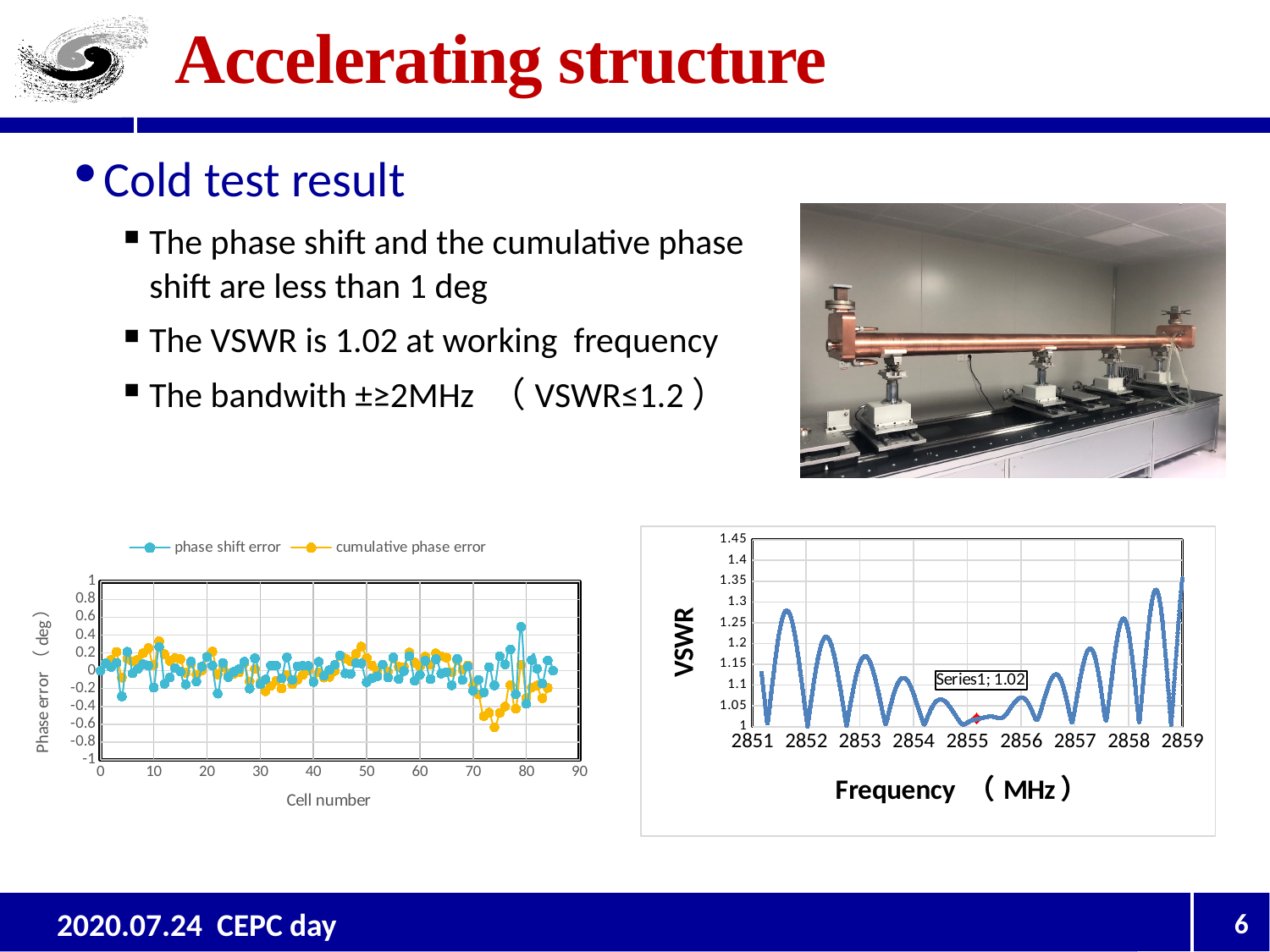
How many series does the legend of the left chart (phase error vs cell number) list? 2 What is the y-axis label of the right chart (VSWR vs frequency)? VSWR What kind of chart is the left chart plotting phase error against cell number? line chart In the right chart (VSWR vs frequency), is the VSWR at 2859 MHz greater or less than 1.3? greater In the right chart (VSWR vs frequency), is the VSWR at 2855 MHz greater or less than 1.1? less What are the two legend entries of the left chart (phase error vs cell number)? phase shift error, cumulative phase error What kind of chart is the right chart plotting VSWR against frequency? line chart What is the x-axis label of the right chart (VSWR vs frequency)? Frequency (MHz) In the right chart (VSWR vs frequency), what VSWR value is shown in the data label on the marked point? 1.02